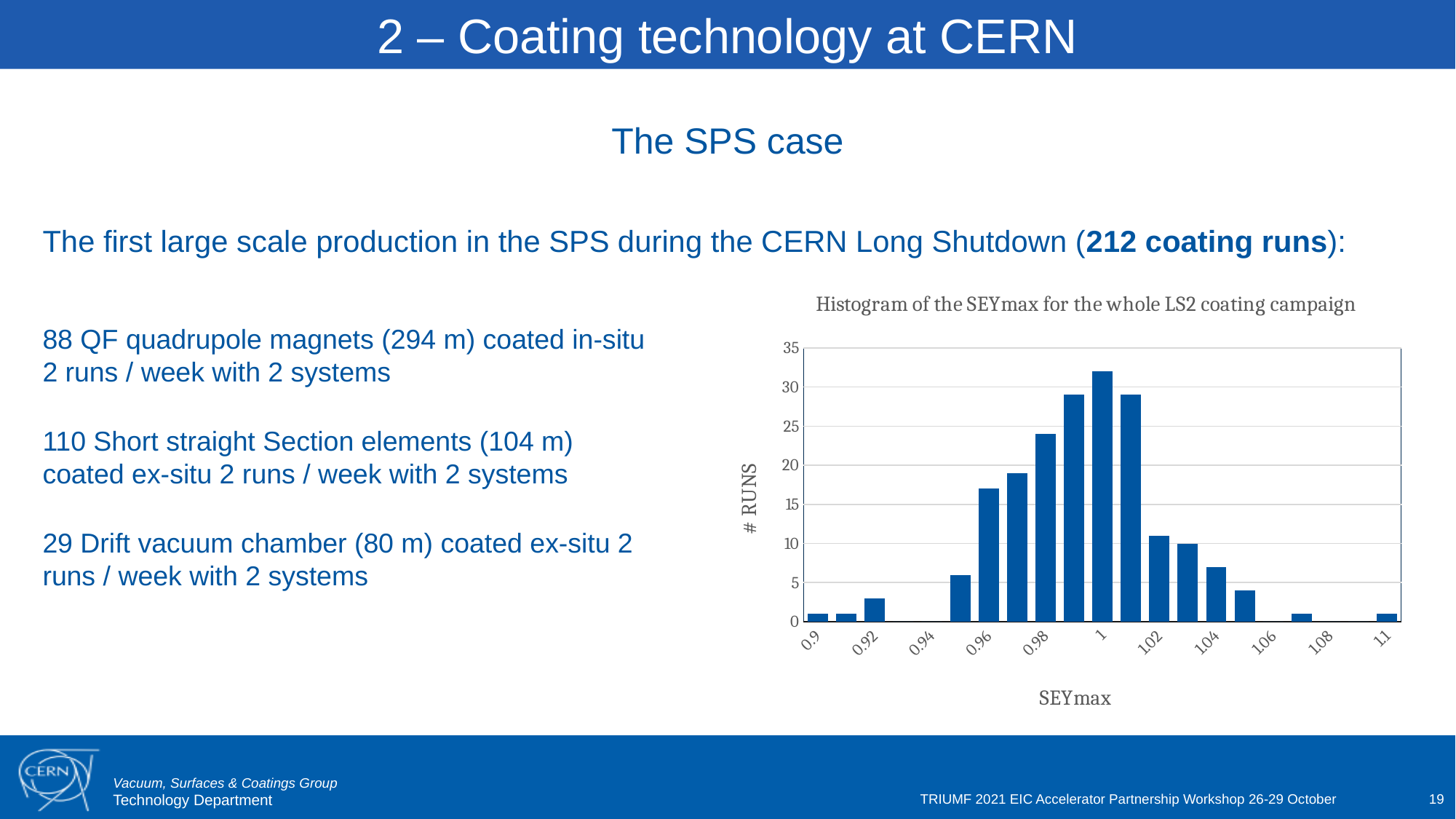
Is the number of runs at SEYmax 0.92 greater or less than 5? less Which has more runs, SEYmax 1.04 or SEYmax 0.96? 0.96 Which has more runs, SEYmax 0.98 or SEYmax 1.02? 0.98 Is the number of runs at SEYmax 0.96 greater or less than 15? greater How many tick labels are shown on the SEYmax axis? 11 What kind of chart is shown on the slide? bar chart What is the title of the chart? Histogram of the SEYmax for the whole LS2 coating campaign Is the number of runs at SEYmax 1 greater or less than 30? greater At which SEYmax value is the number of runs highest? 1 What is the label of the vertical axis of the chart? # RUNS